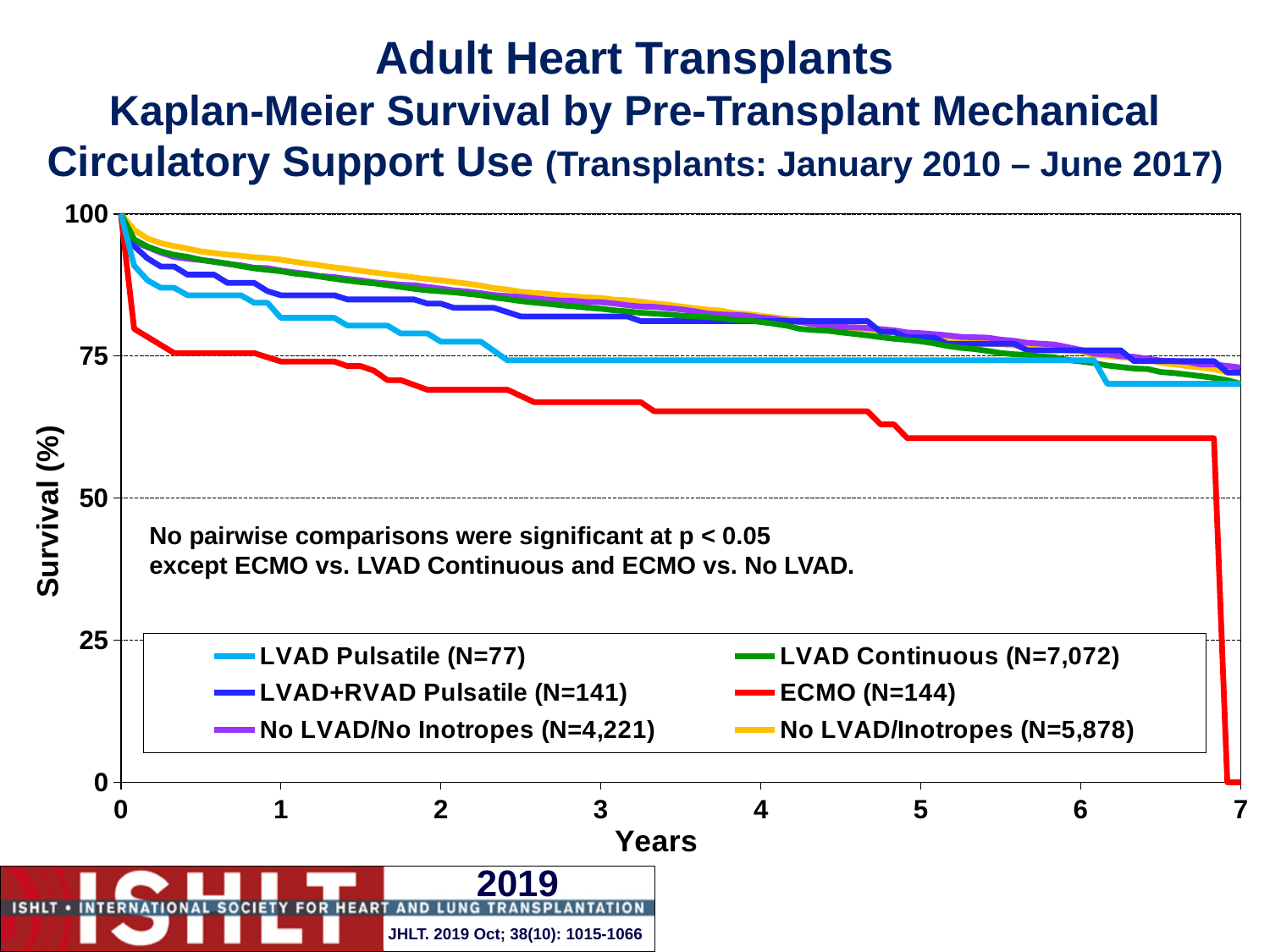
Do the survival curves rise or fall as years increase? Fall What is the N for the ECMO series in the legend? 144 What is the label of the y axis? Survival (%) Is the survival for No LVAD/Inotropes at 1 year greater or less than 75? greater Is the survival for ECMO at 3 years greater or less than 50? greater Which series has the lowest survival at 2 years? ECMO (N=144) What kind of chart is shown on the slide? Line chart Is the survival for ECMO at 5 years greater or less than 75? less At 4 years, which has higher survival: ECMO or LVAD Continuous? LVAD Continuous How many series does the legend list? 6 Which series has the lowest survival at 5 years? ECMO (N=144)